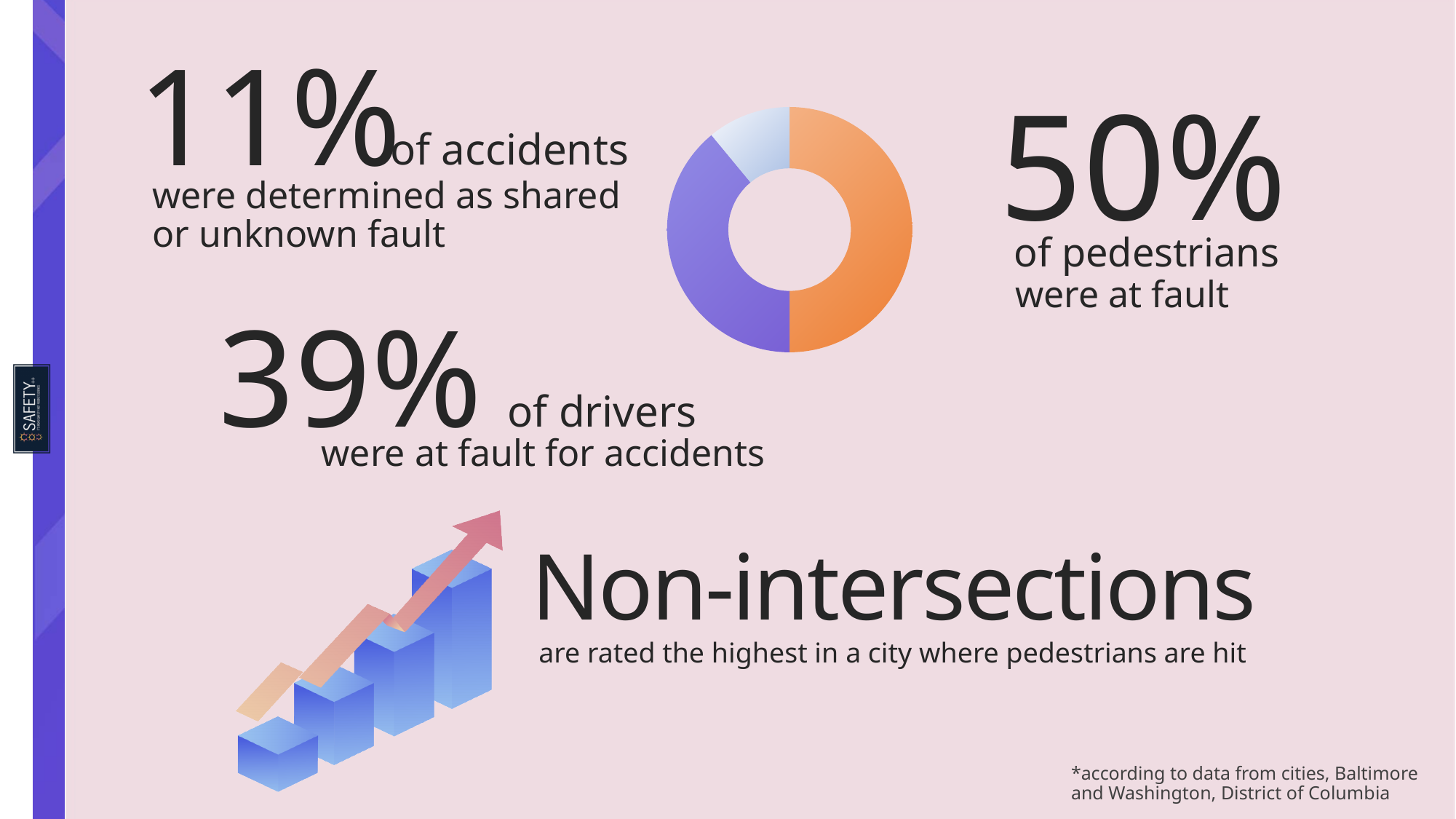
What colour is the largest slice of the donut chart? orange What is the difference between the share of pedestrians at fault and the share of drivers at fault? 11 percentage points How many slices does the donut chart have? 3 What percentage of pedestrians were at fault? 50% What percentage of drivers were at fault for accidents? 39% Which slice of the donut chart is the smallest? the light blue slice (11%) Which slice of the donut chart is the largest? the orange slice (50%) What share of the donut chart does the orange slice take up? 50% Which is larger in the donut chart, the orange slice or the purple slice? the orange slice What percentage of accidents were determined as shared or unknown fault? 11% What is the difference between the share of drivers at fault (39%) and the share of shared or unknown fault (11%)? 28 percentage points What kind of chart is shown in the centre of the slide? donut (pie) chart